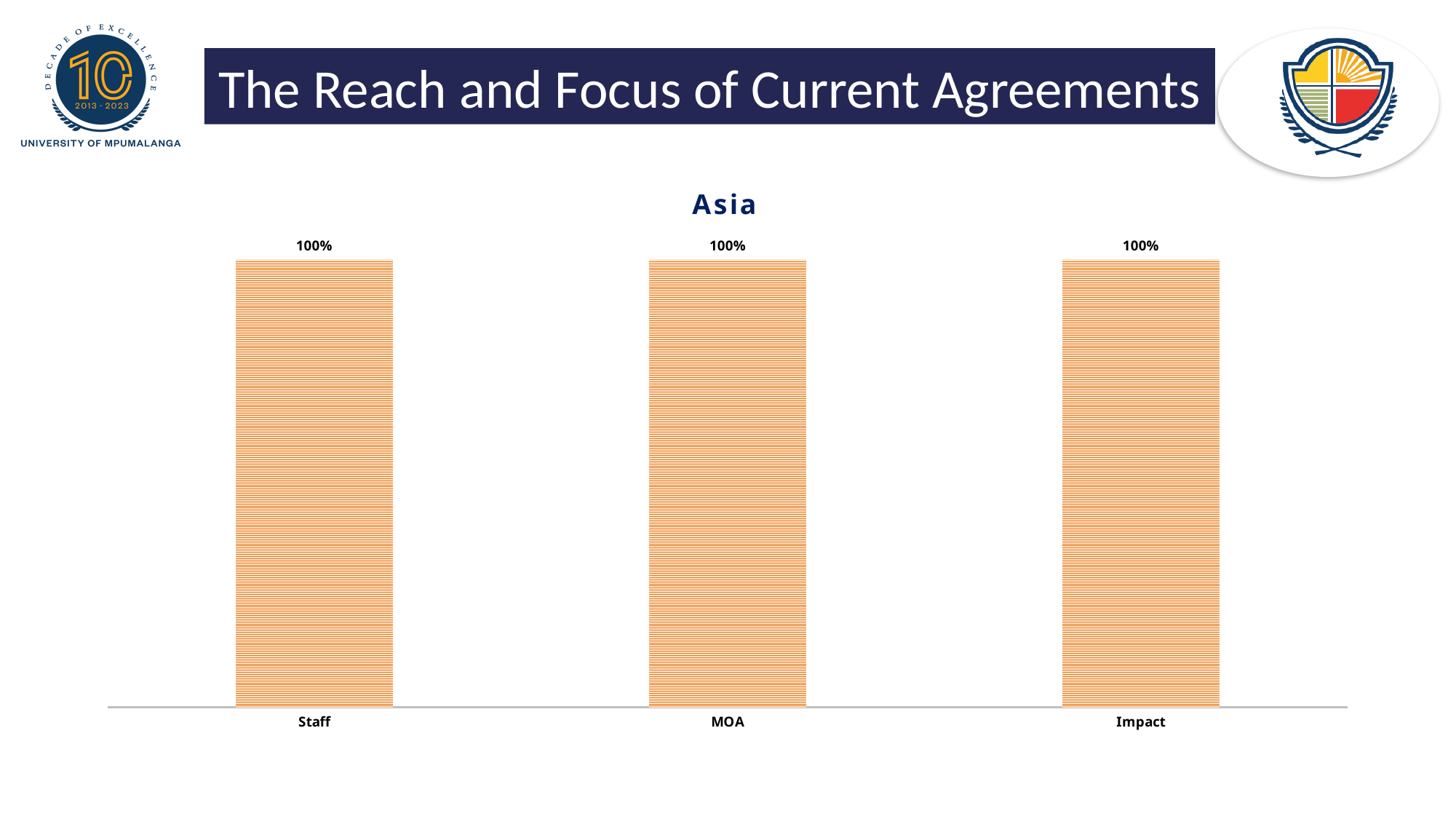
What is the value for Staff? 100% Do the values rise, fall or stay the same across the categories from Staff to Impact? Stay the same What colour are the bars in the chart? Orange What is the title of the chart? Asia What is the difference between the values for Staff and MOA? 0% What is the value for Impact? 100% How many categories are shown on the x axis? 3 What is the value for MOA? 100% What is the difference between the values for MOA and Impact? 0% What kind of chart is shown on the slide? Bar chart